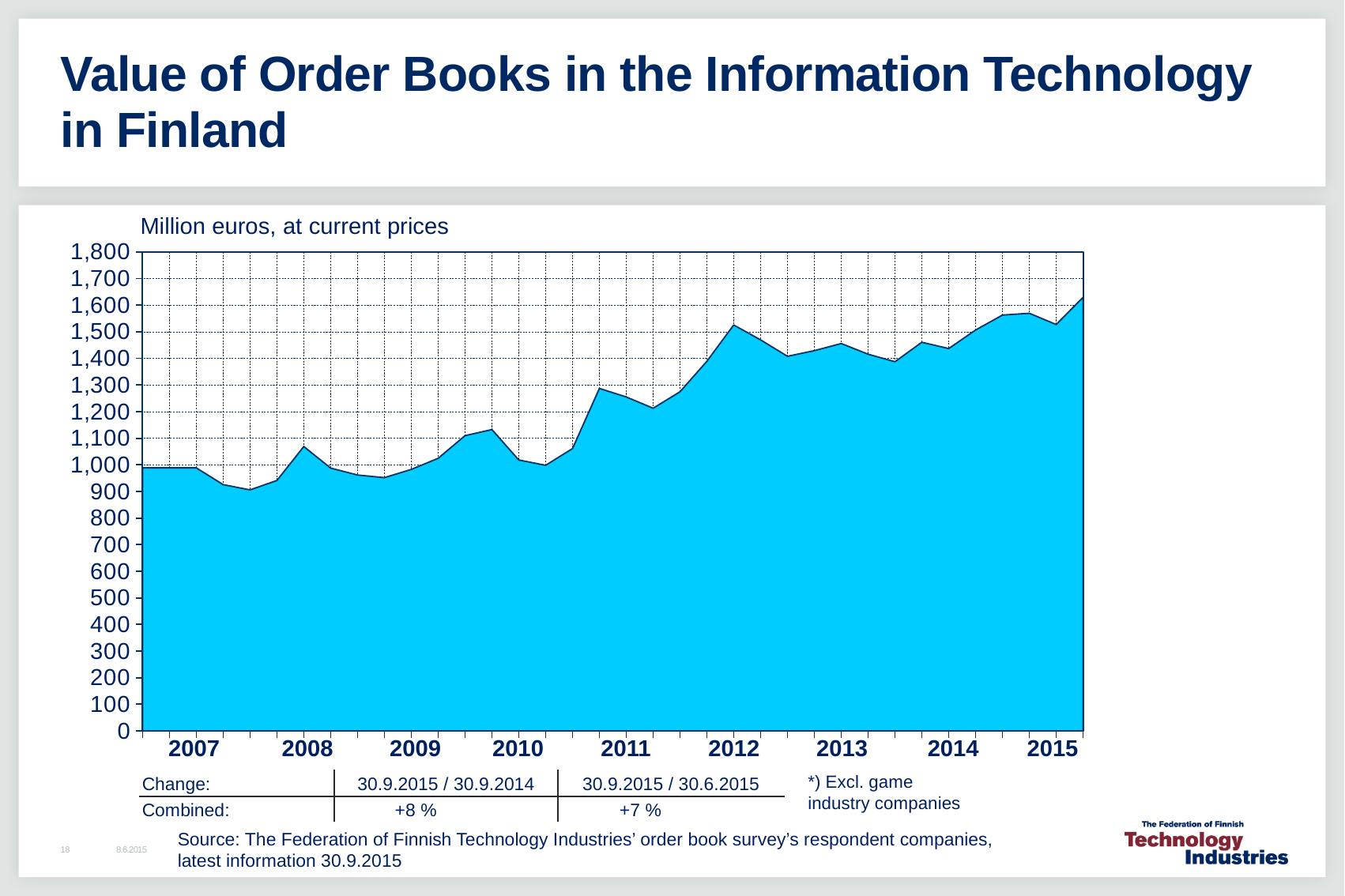
Which is larger: the peak value in 2008 or the peak value in 2011? 2011 In which year does the chart reach its highest value? 2015 Is the value at the end of 2015 greater or less than 1,600? greater Is the value at the start of 2010 greater or less than 1,100? greater What kind of chart is shown on the slide? Area chart Is the peak value in 2008 greater or less than 1,000? greater According to the table below the chart, what is the combined change for 30.9.2015 / 30.9.2014? +8 % Which is larger: the peak value in 2012 or the value at the end of 2015? End of 2015 Overall, do the values rise or fall from 2007 to 2015? Rise What unit is stated above the chart's y axis? Million euros, at current prices How many years are labelled on the x axis of the chart? 9